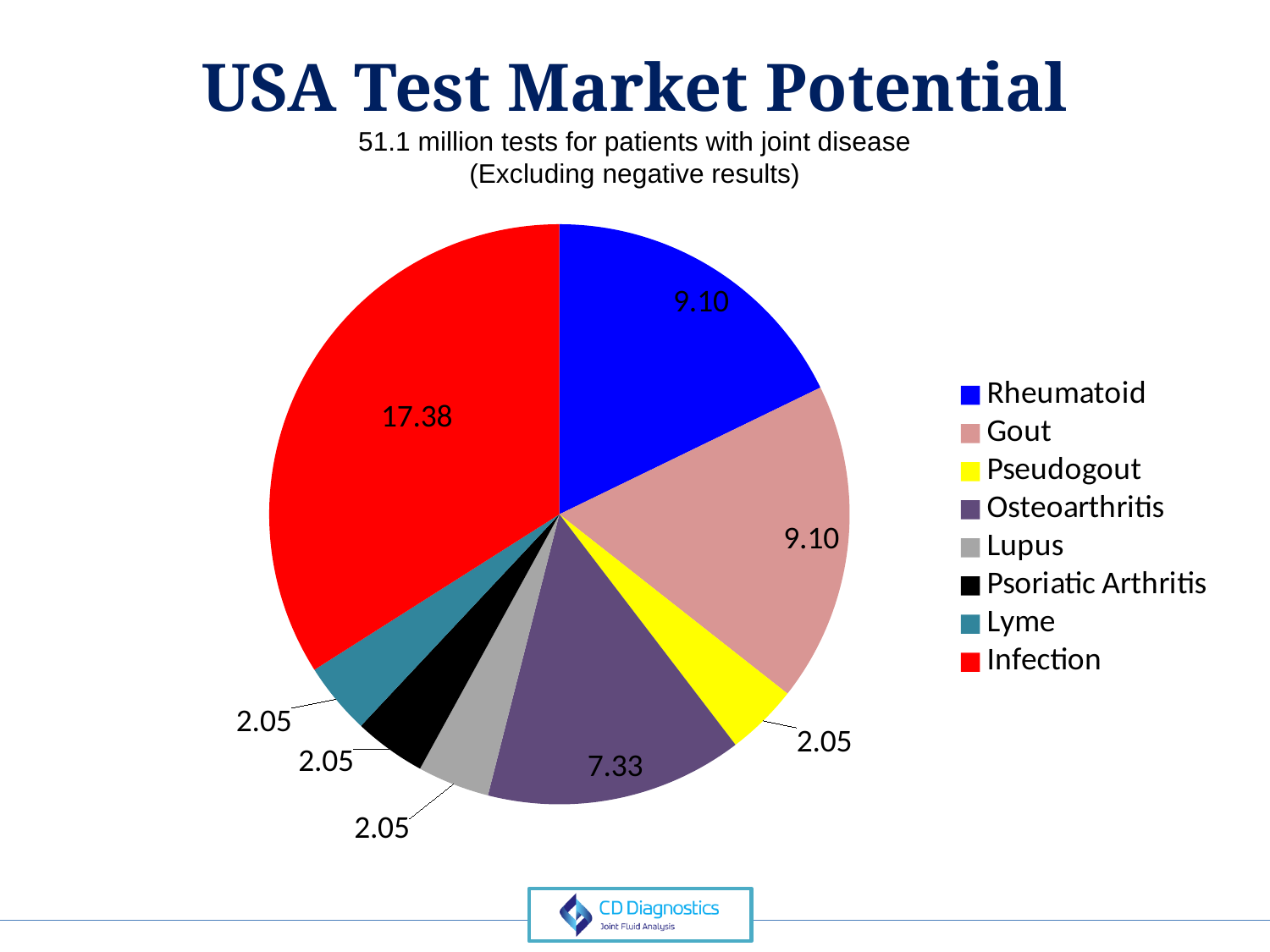
What colour is the Pseudogout slice? Yellow What value is shown for the Infection slice? 17.38 What value is shown for the Osteoarthritis slice? 7.33 Which category has the largest slice of the pie? Infection How many categories does the legend list? 8 What value is shown for the Rheumatoid slice? 9.10 What is the difference between the Infection value and the Osteoarthritis value? 10.05 What is the difference between the Rheumatoid value and the Pseudogout value? 7.05 What kind of chart is shown on the slide? Pie chart Which is larger, the Infection slice or the Gout slice? Infection What value is shown for the Lyme slice? 2.05 What is the smallest value labelled on the pie chart? 2.05